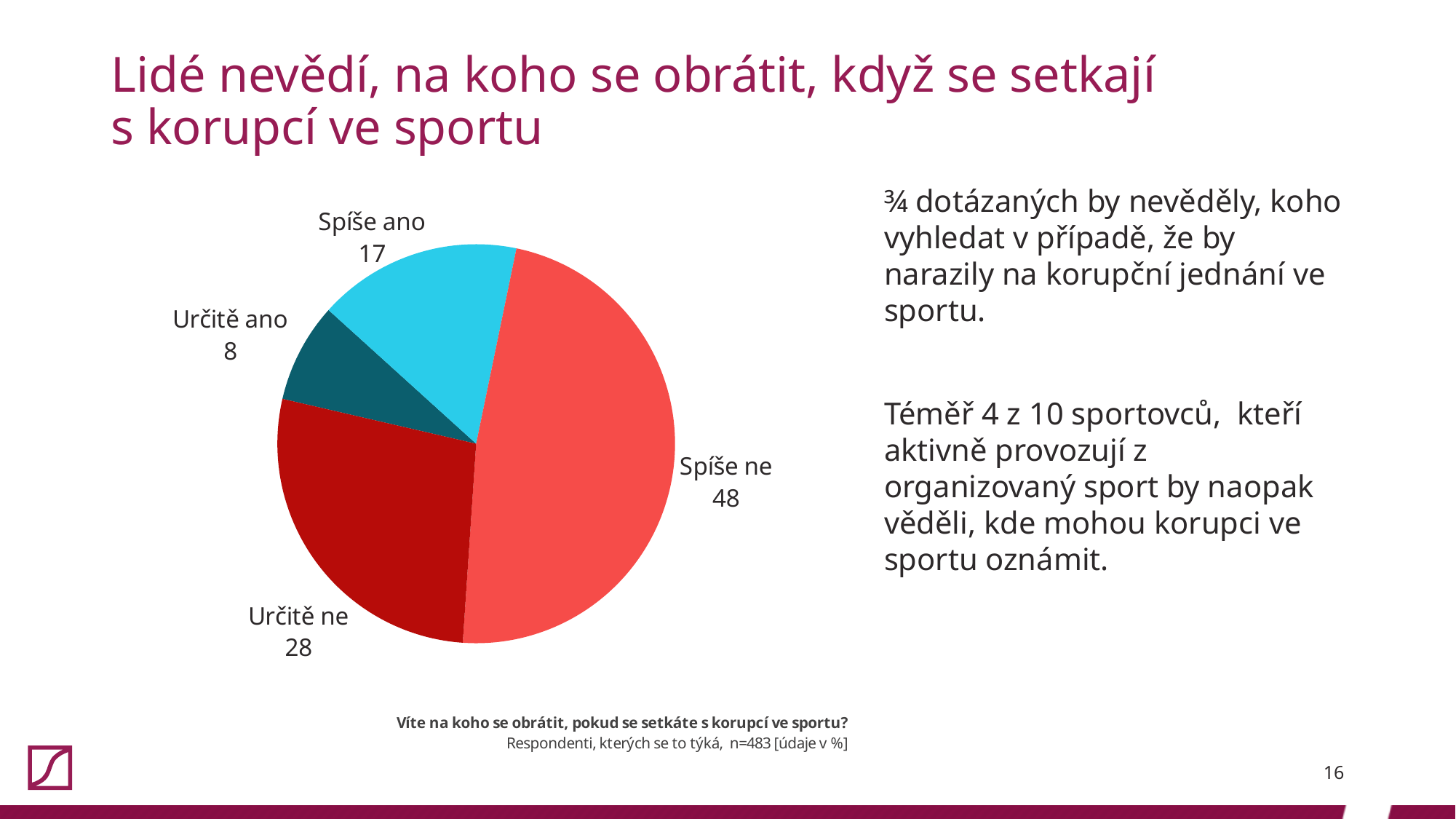
What is the difference between the values for "Spíše ne" and "Určitě ne"? 20 What is the value for "Spíše ne"? 48 What is the value for "Určitě ne"? 28 What is the value for "Určitě ano"? 8 What is the combined value of "Spíše ano" and "Určitě ano"? 25 What colour is the "Spíše ano" slice? light blue What is the value for "Spíše ano"? 17 How many slices does the pie chart have? 4 Which category has the largest slice of the pie? Spíše ne Which category has the smallest slice of the pie? Určitě ano Which is larger, the value for "Spíše ano" or the value for "Určitě ano"? Spíše ano What kind of chart is shown on the slide? pie chart